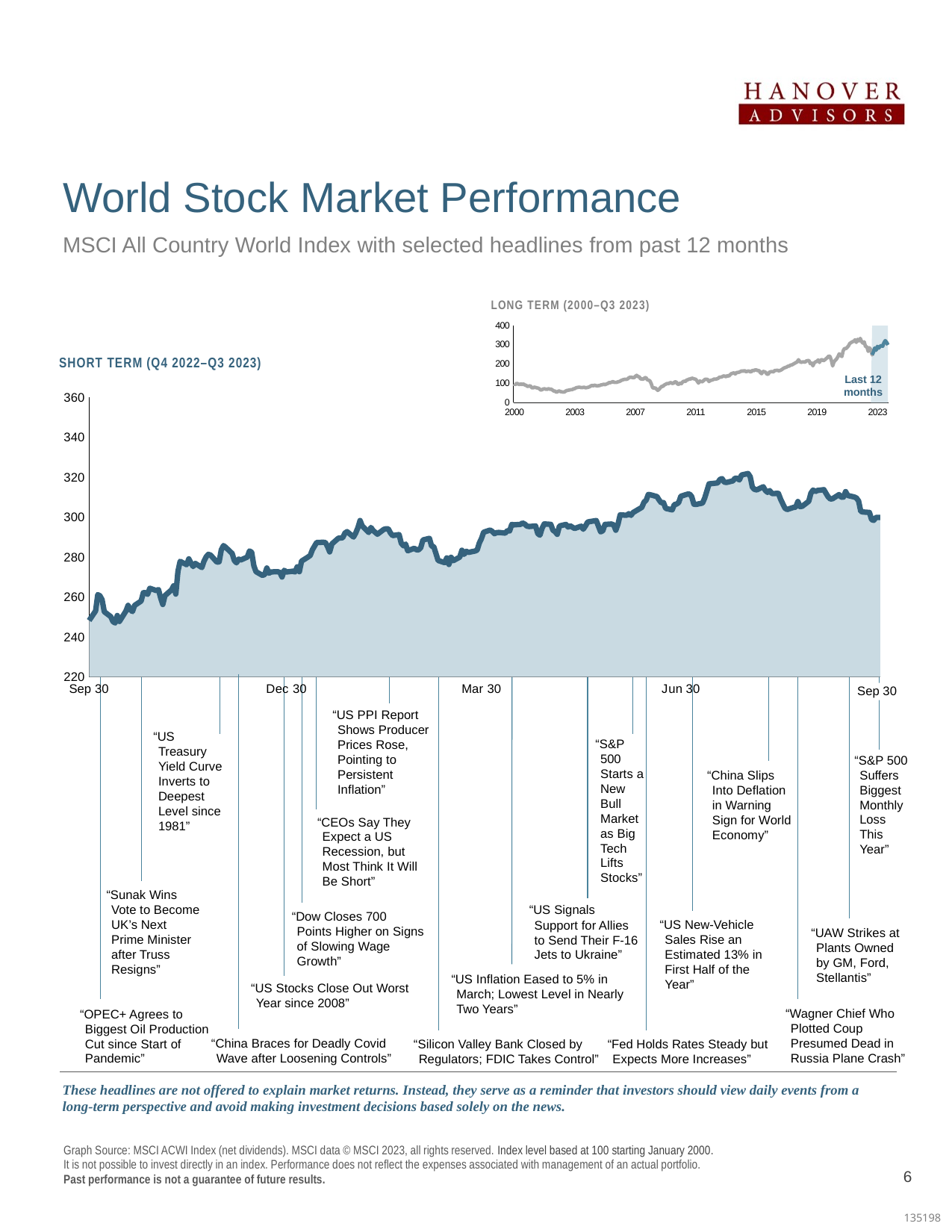
In the SHORT TERM chart, is the highest point of the index greater or less than 300? greater In the LONG TERM chart, does the index generally rise or fall from 2000 to 2023? rise What kind of chart is the LONG TERM (2000–Q3 2023) chart? line chart How many date labels are shown on the x axis of the SHORT TERM chart? 5 In the LONG TERM chart, what is the index level at the start of January 2000? 100 In the SHORT TERM chart, is the index value at Sep 30 (the end of the period) greater or less than 280? greater In the LONG TERM chart, what does the shaded region at the right end of the line represent? Last 12 months In the LONG TERM chart, is the index value at 2023 greater or less than 200? greater What kind of chart is the SHORT TERM (Q4 2022–Q3 2023) chart? area chart How many year labels are shown on the x axis of the LONG TERM chart? 7 In the SHORT TERM chart, does the index end the period higher or lower than it started? higher